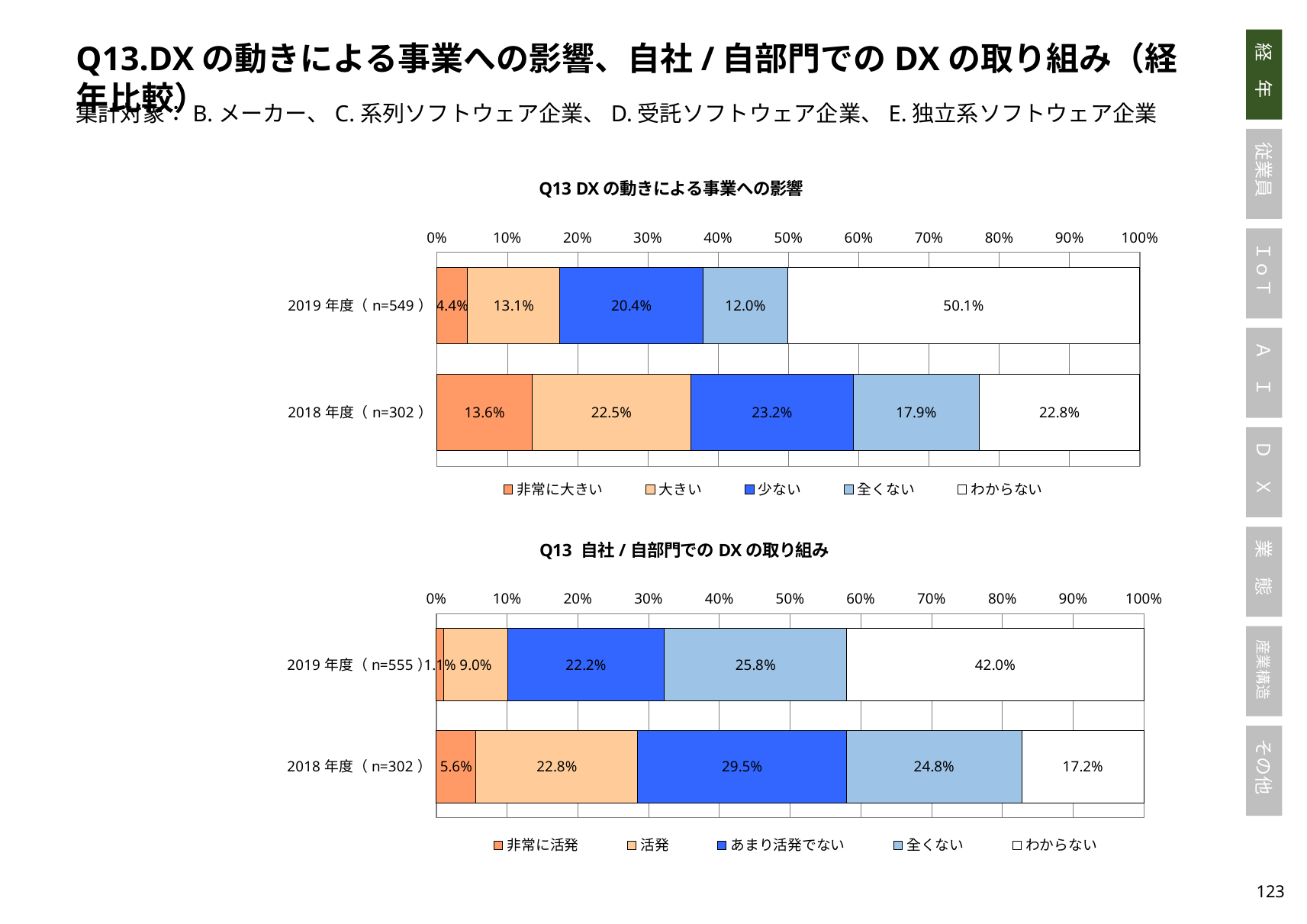
In the bottom chart (Q13 自社/自部門でのDXの取り組み), what is the value for あまり活発でない in 2018年度? 29.5% In the bottom chart (Q13 自社/自部門でのDXの取り組み), what is the value for 全くない in 2019年度? 25.8% In the bottom chart (Q13 自社/自部門でのDXの取り組み), what is the sample size (n) for 2019年度? 555 In the top chart (Q13 DXの動きによる事業への影響), what is the difference between 大きい in 2018年度 and 大きい in 2019年度? 9.4% In the top chart (Q13 DXの動きによる事業への影響), what is the value for 非常に大きい in 2018年度? 13.6% In the top chart (Q13 DXの動きによる事業への影響), how many series does the legend list? 5 In the top chart (Q13 DXの動きによる事業への影響), which category has the highest value in the 2019年度 bar? わからない In the bottom chart (Q13 自社/自部門でのDXの取り組み), which is larger: わからない in 2019年度 or わからない in 2018年度? 2019年度 In the bottom chart (Q13 自社/自部門でのDXの取り組み), what is the difference between 活発 in 2018年度 and 活発 in 2019年度? 13.8% What kind of chart is the top chart (Q13 DXの動きによる事業への影響)? Stacked bar chart In the top chart (Q13 DXの動きによる事業への影響), what is the value for わからない in 2019年度? 50.1% In the bottom chart (Q13 自社/自部門でのDXの取り組み), which category has the lowest value in the 2019年度 bar? 非常に活発